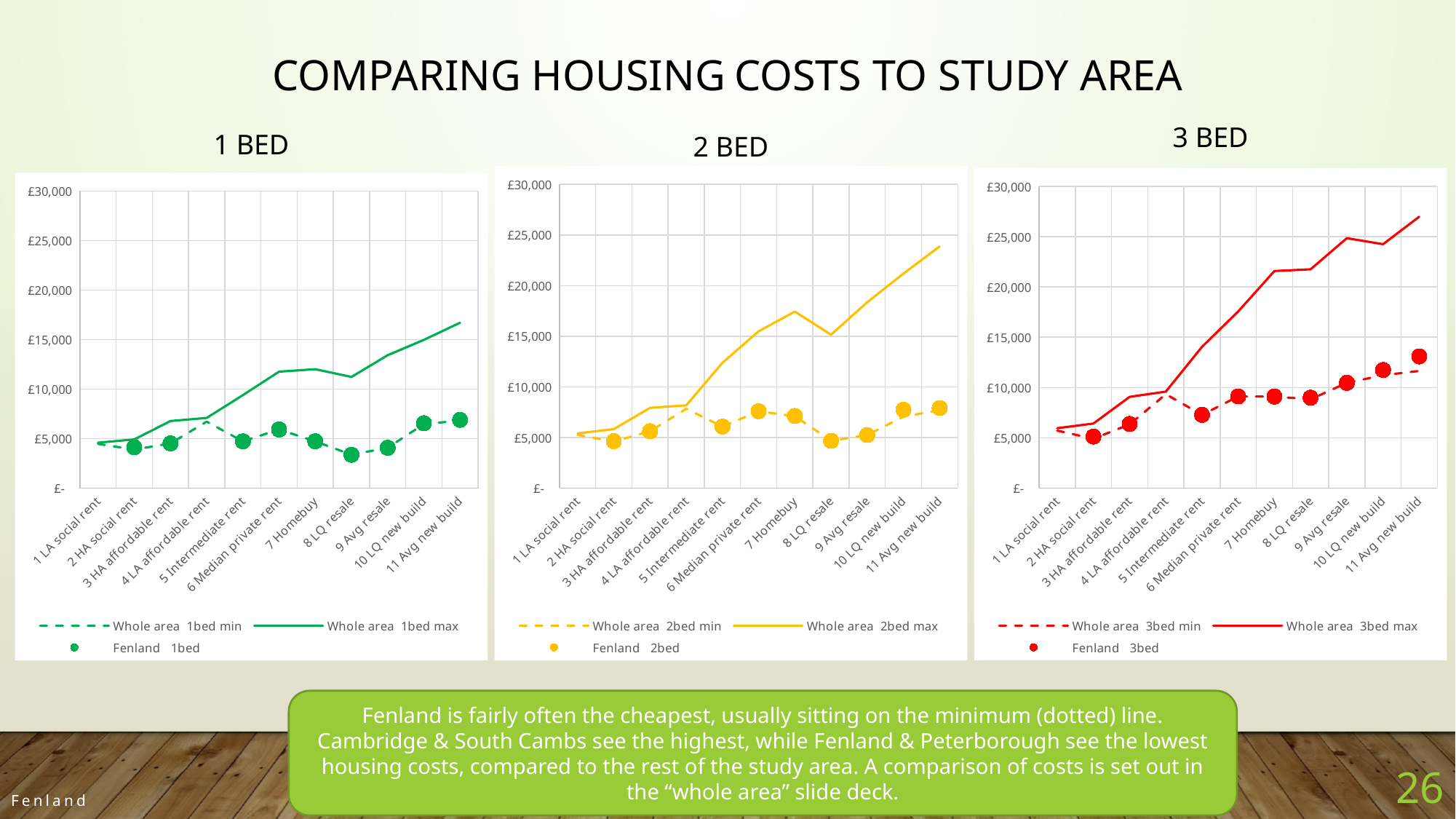
In the 3 BED chart, is the value of Whole area 3bed max for 11 Avg new build greater or less than £25,000? greater In the 2 BED chart, which is larger for Whole area 2bed max: the value for 7 Homebuy or the value for 8 LQ resale? 7 Homebuy In the 1 BED chart, is the Fenland 1bed value for 8 LQ resale greater or less than £5,000? less What kind of chart is the 1 BED chart? line chart In the 2 BED chart, is the value of Whole area 2bed max for 11 Avg new build greater or less than £20,000? greater In the 3 BED chart, which category has the highest Fenland 3bed value? 11 Avg new build How many categories are shown on the x axis of the 2 BED chart? 11 What colour are the lines and markers in the 3 BED chart? red How many series does the legend of the 3 BED chart list? 3 In the 3 BED chart, which category has the lowest Fenland 3bed value? 2 HA social rent In the 3 BED chart, does the Whole area 3bed max line generally rise or fall from left to right along the x axis? rise